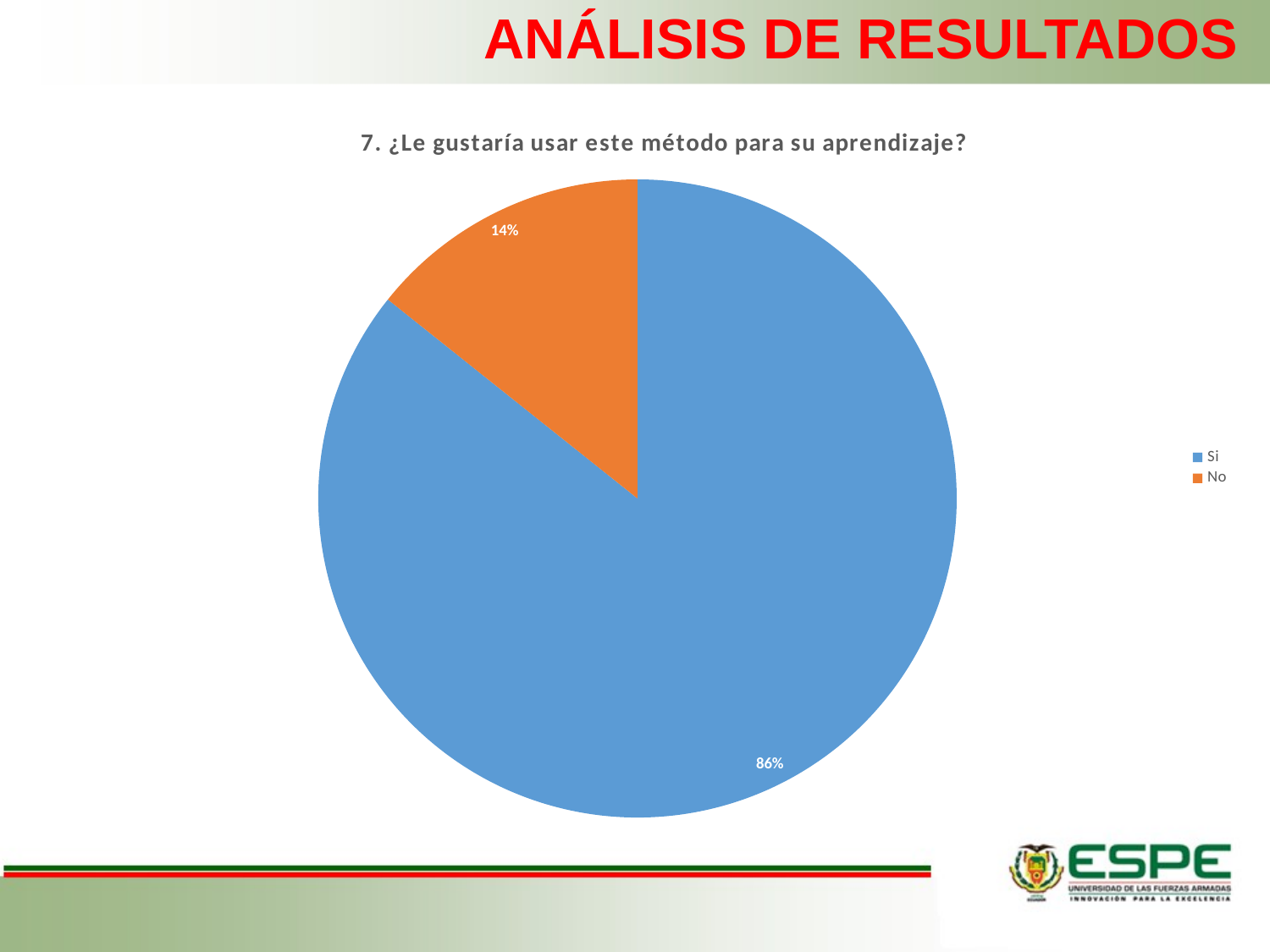
What colour is the "No" slice in the pie chart? Orange What is the difference in percentage points between the "Si" and "No" slices? 72 What type of chart is shown on the slide? Pie chart What is the title of the chart? 7. ¿Le gustaría usar este método para su aprendizaje? What percentage of the pie chart corresponds to "No"? 14% Which category has the smallest share of the pie chart? No Which category has the largest share of the pie chart? Si Which slice is larger, "Si" or "No"? Si How many entries does the legend list? 2 What share of the pie does the "No" slice represent? 14% What percentage of the pie chart corresponds to "Si"? 86% How many slices does the pie chart have? 2